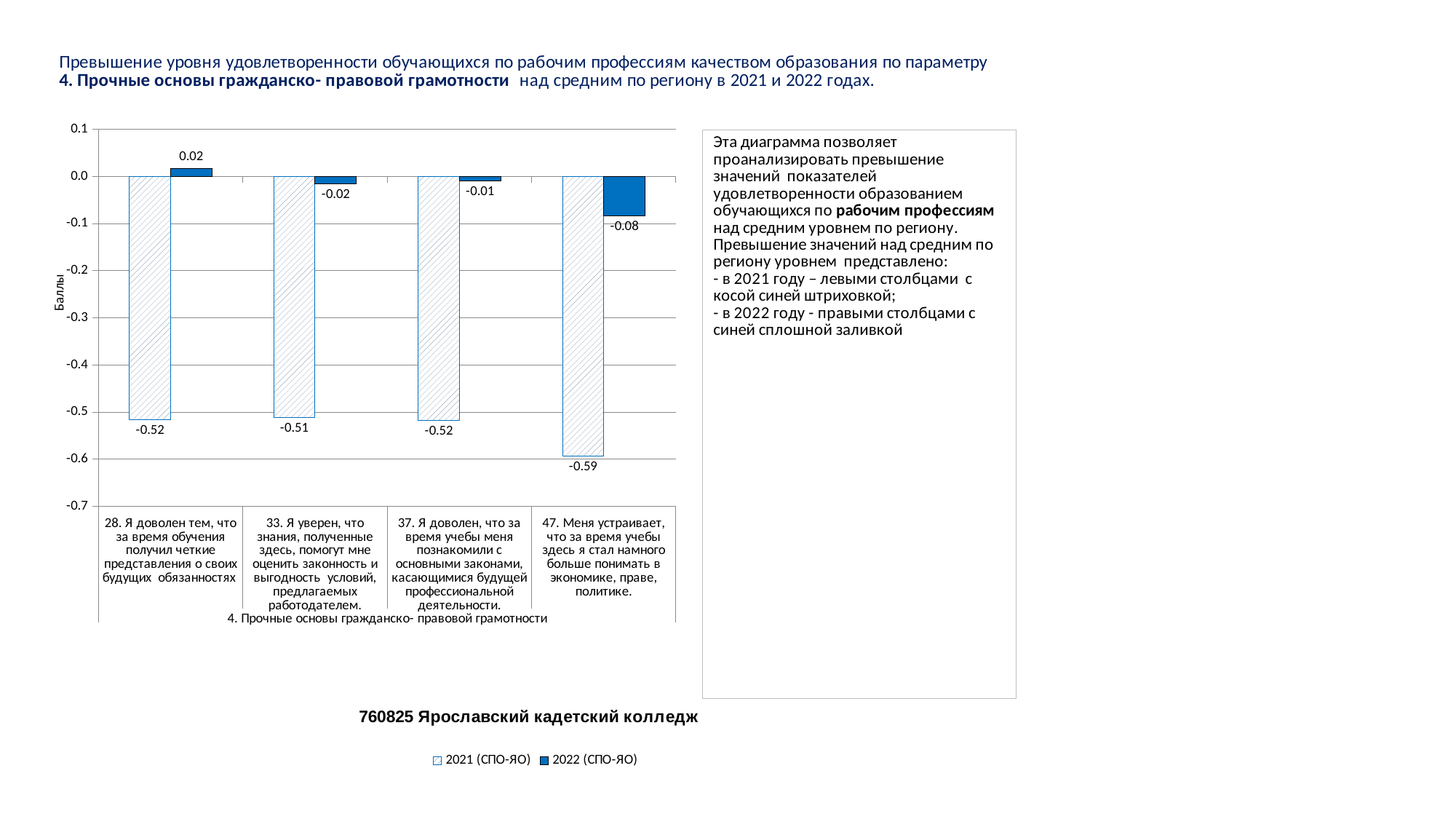
What is the 2022 (СПО-ЯО) value for category 33 ("Я уверен, что знания, полученные здесь, помогут мне оценить законность и выгодность условий, предлагаемых работодателем")? -0.02 What is the 2021 (СПО-ЯО) value for category 28 ("Я доволен тем, что за время обучения получил четкие представления о своих будущих обязанностях")? -0.52 Which category has the highest 2022 (СПО-ЯО) value? 28. Я доволен тем, что за время обучения получил четкие представления о своих будущих обязанностях Which is larger for category 37: the 2021 (СПО-ЯО) value or the 2022 (СПО-ЯО) value? 2022 (СПО-ЯО) What is the label of the vertical axis of the chart? Баллы Which series is shown with diagonal blue hatching? 2021 (СПО-ЯО) What is the difference between the 2022 and 2021 values for category 47? 0.51 What is the 2022 (СПО-ЯО) value for category 47 ("Меня устраивает, что за время учебы здесь я стал намного больше понимать в экономике, праве, политике")? -0.08 How many series does the legend list? 2 What kind of chart is shown on the slide? Bar chart Which category has the lowest 2021 (СПО-ЯО) value? 47. Меня устраивает, что за время учебы здесь я стал намного больше понимать в экономике, праве, политике. How many categories are shown on the x axis of the chart? 4